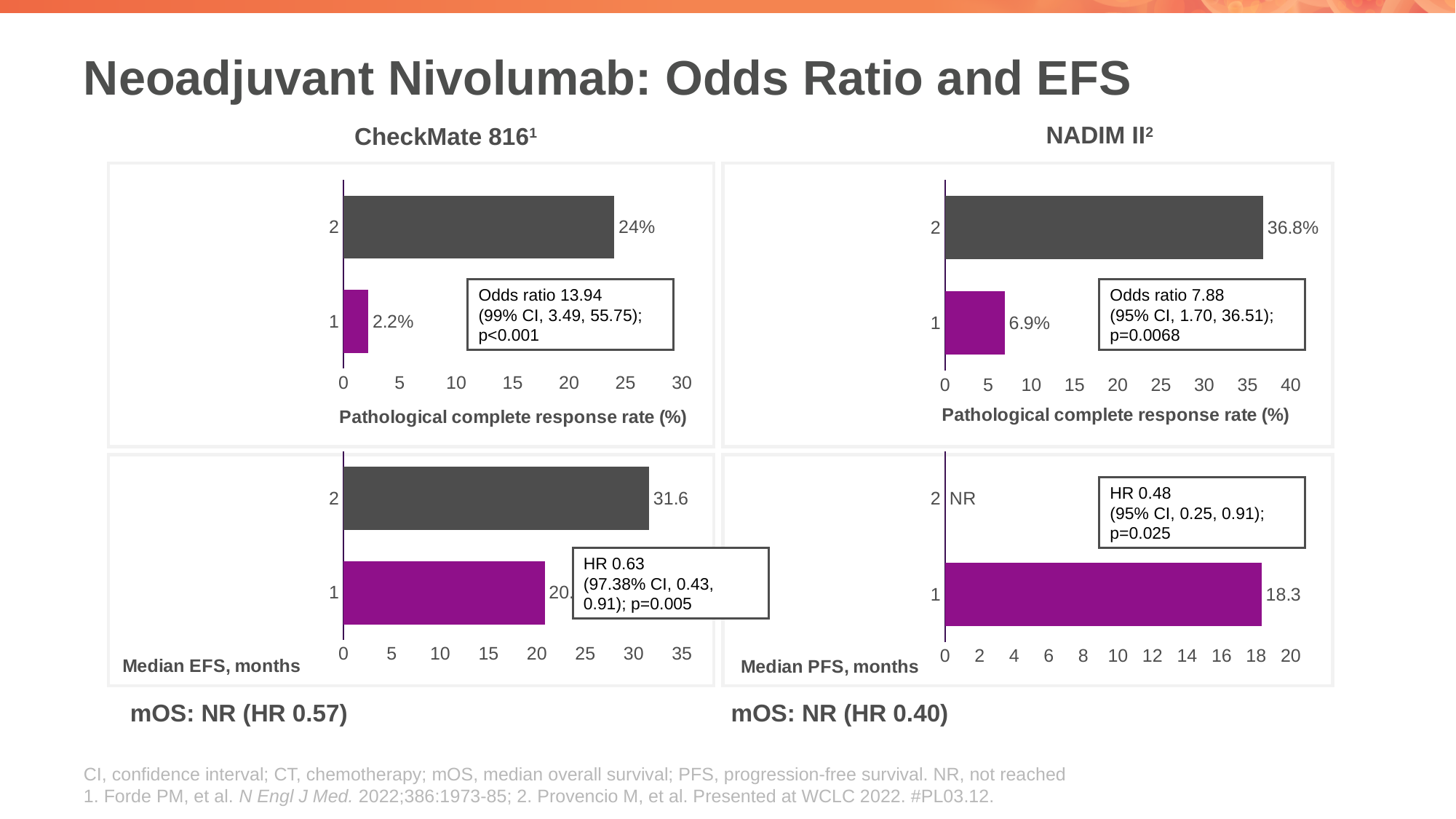
In the CheckMate 816 pathological complete response rate chart, what is the value for category 1? 2.2% In the CheckMate 816 pathological complete response rate chart, what is the value for category 2? 24% In the CheckMate 816 Median EFS chart, what is the value for category 2? 31.6 In the CheckMate 816 pathological complete response rate chart, which category has the higher value, 1 or 2? 2 In the CheckMate 816 Median EFS chart, is the value for category 1 greater or less than 25? less In the NADIM II Median PFS chart, what is shown as the value for category 2? NR In the NADIM II pathological complete response rate chart, what is the value for category 2? 36.8% In the NADIM II pathological complete response rate chart, what is the value for category 1? 6.9% In the NADIM II pathological complete response rate chart, what is the difference between the values for category 2 and category 1? 29.9 percentage points What is the x-axis label of the top-left chart under CheckMate 816? Pathological complete response rate (%) In the NADIM II Median PFS chart, what is the value for category 1? 18.3 What kind of chart is the NADIM II Median PFS chart? Bar chart